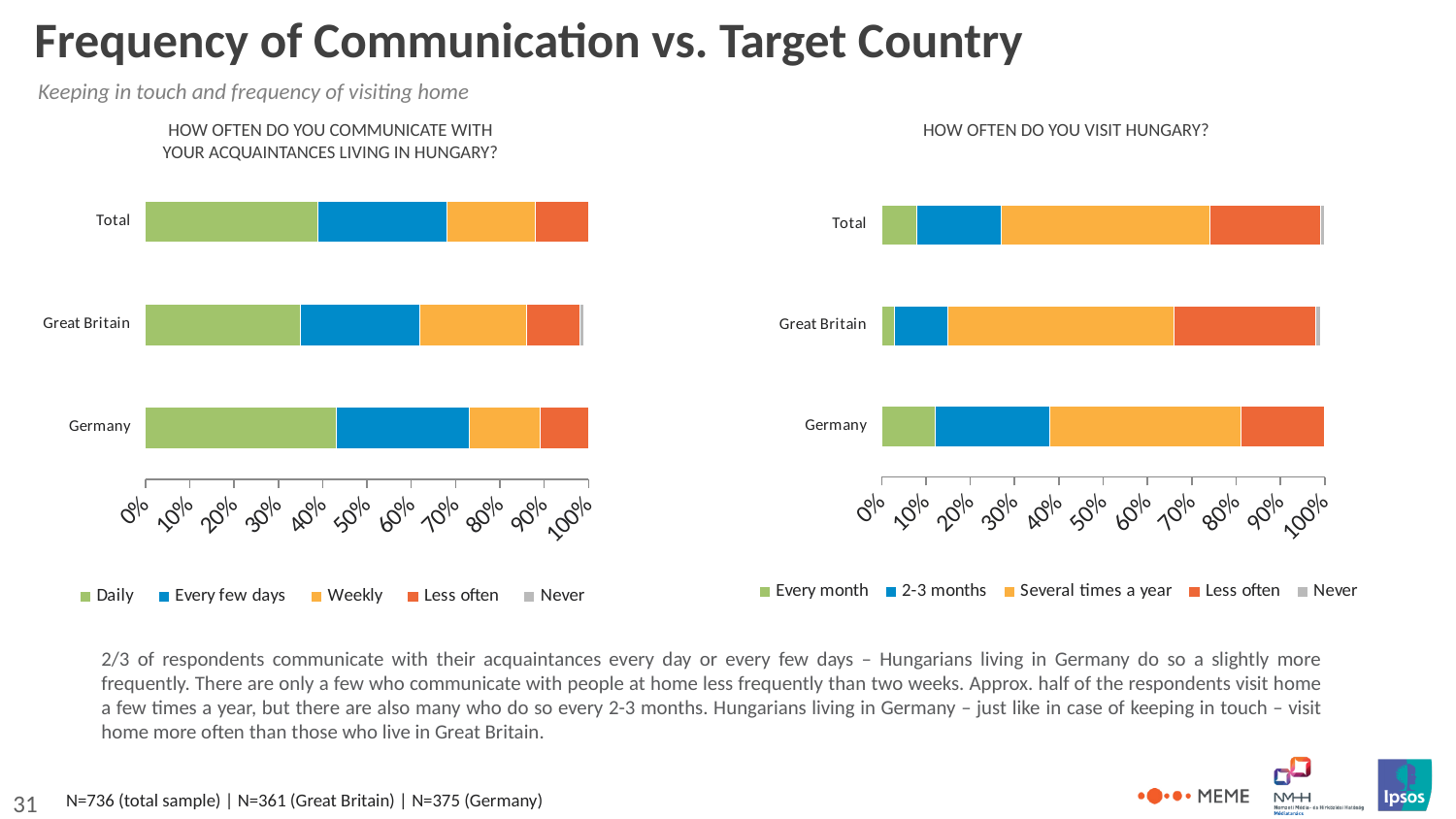
How many series does the legend list for the chart titled 'How often do you visit Hungary?'? 5 On the chart titled 'How often do you communicate with your acquaintances living in Hungary?', is the 'Daily' share for Great Britain greater or less than 40%? less What kind of chart is the chart titled 'How often do you communicate with your acquaintances living in Hungary?'? Stacked bar chart On the chart titled 'How often do you visit Hungary?', which series is shown in orange/yellow in the legend? Several times a year On the chart titled 'How often do you visit Hungary?', which has a larger 'Every month' share, Germany or Great Britain? Germany On the chart titled 'How often do you visit Hungary?', which category has the largest 'Every month' share? Germany How many series does the legend list for the chart titled 'How often do you communicate with your acquaintances living in Hungary?'? 5 On the chart titled 'How often do you visit Hungary?', which has a larger 'Less often' share, Great Britain or Germany? Great Britain How many categories are shown on the chart titled 'How often do you visit Hungary?'? 3 On the chart titled 'How often do you communicate with your acquaintances living in Hungary?', which has a larger 'Daily' share, Germany or Great Britain? Germany On the chart titled 'How often do you communicate with your acquaintances living in Hungary?', what is the first series listed in the legend? Daily On the chart titled 'How often do you visit Hungary?', is the 'Every month' share for Great Britain greater or less than 10%? less